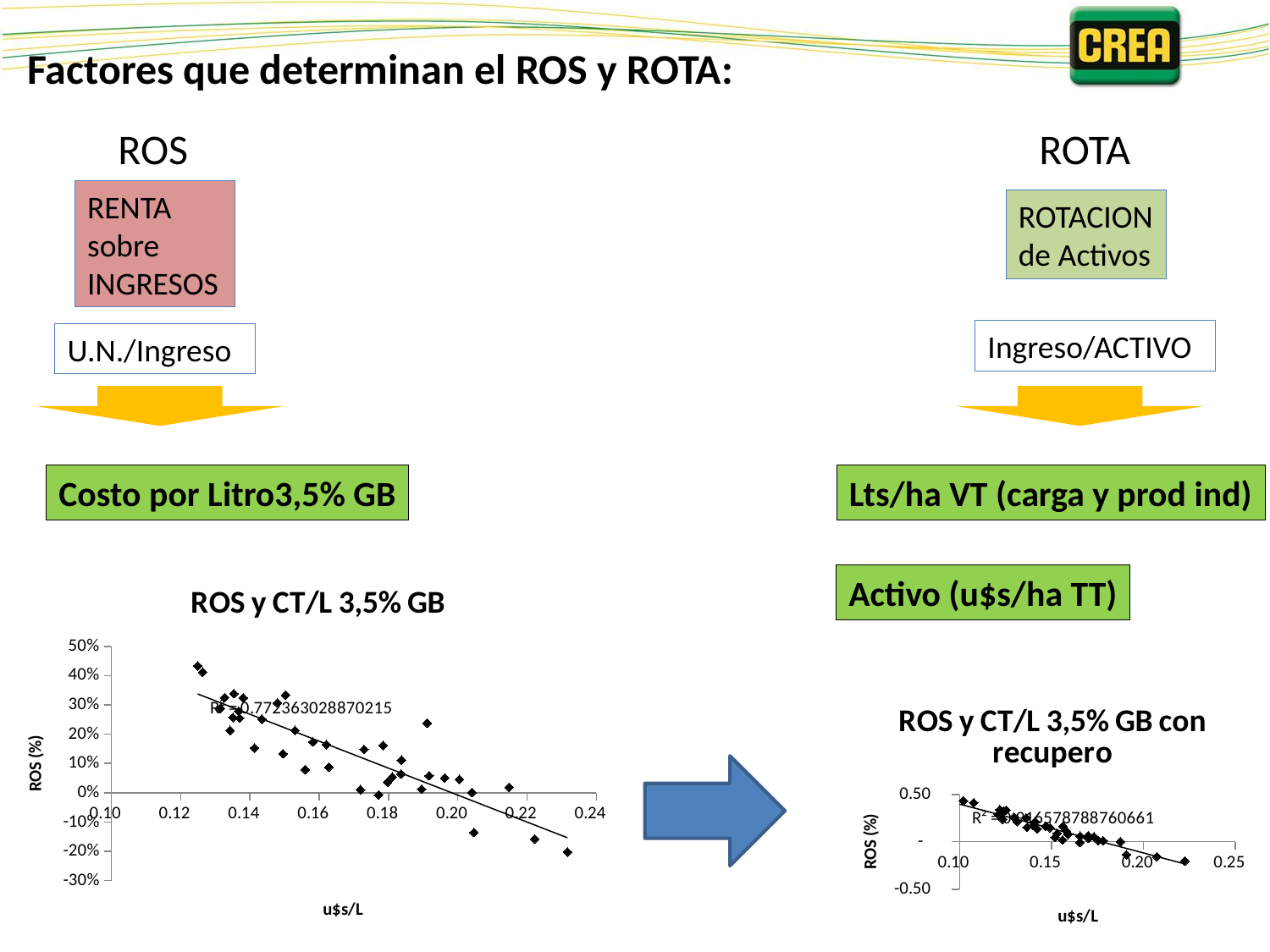
In the chart titled "ROS y CT/L 3,5% GB", do the ROS values rise or fall as u$s/L increases? fall What type of chart is the chart titled "ROS y CT/L 3,5% GB con recupero"? scatter chart What is the highest value shown on the y axis of the chart titled "ROS y CT/L 3,5% GB"? 50% What is the x-axis title of the chart titled "ROS y CT/L 3,5% GB"? u$s/L What is the highest value shown on the x axis of the chart titled "ROS y CT/L 3,5% GB"? 0.24 What is the R² value shown on the chart titled "ROS y CT/L 3,5% GB"? 0.772363028870215 What is the y-axis title of the chart titled "ROS y CT/L 3,5% GB con recupero"? ROS (%) In the chart titled "ROS y CT/L 3,5% GB con recupero", do the ROS values rise or fall as u$s/L increases? fall What is the highest value shown on the x axis of the chart titled "ROS y CT/L 3,5% GB con recupero"? 0.25 What type of chart is the chart titled "ROS y CT/L 3,5% GB"? scatter chart What is the lowest value shown on the y axis of the chart titled "ROS y CT/L 3,5% GB"? -30%